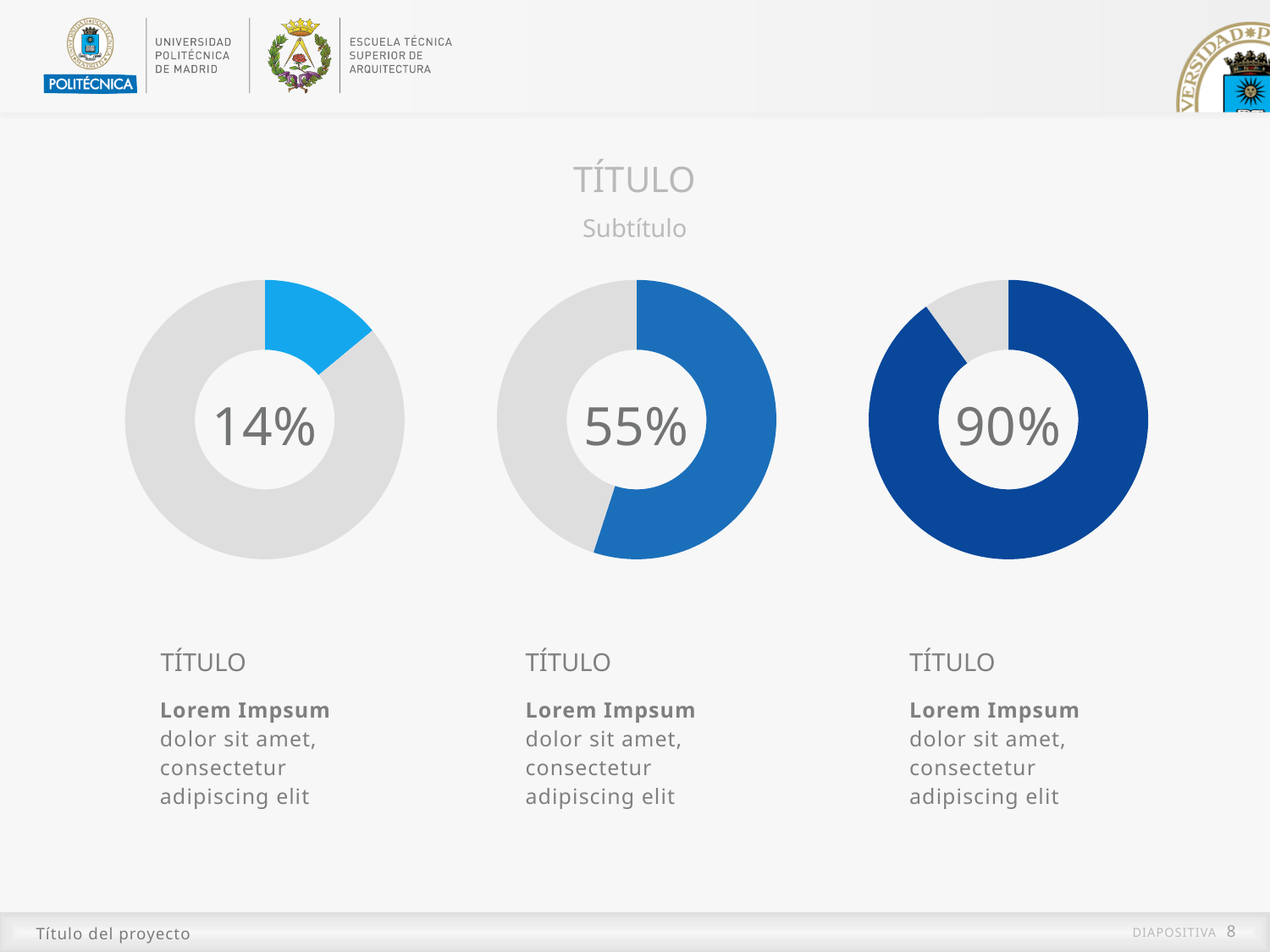
What is the title shown above the three donut charts? TÍTULO What percentage is shown in the centre of the left donut chart? 14% Which of the three donut charts shows the highest percentage? The right chart (90%) What is the difference between the percentage in the right donut chart and the percentage in the left donut chart? 76% What kind of chart is used to display the three percentages on the slide? Donut chart What is the difference between the percentage in the middle donut chart and the percentage in the left donut chart? 41% Is the value shown in the middle donut chart greater or less than 50%? greater Is the percentage in the middle donut chart larger or smaller than the percentage in the right donut chart? Smaller Which of the three donut charts shows the lowest percentage? The left chart (14%) How many donut charts are on the slide? 3 What percentage is shown in the centre of the middle donut chart? 55% What percentage is shown in the centre of the right donut chart? 90%